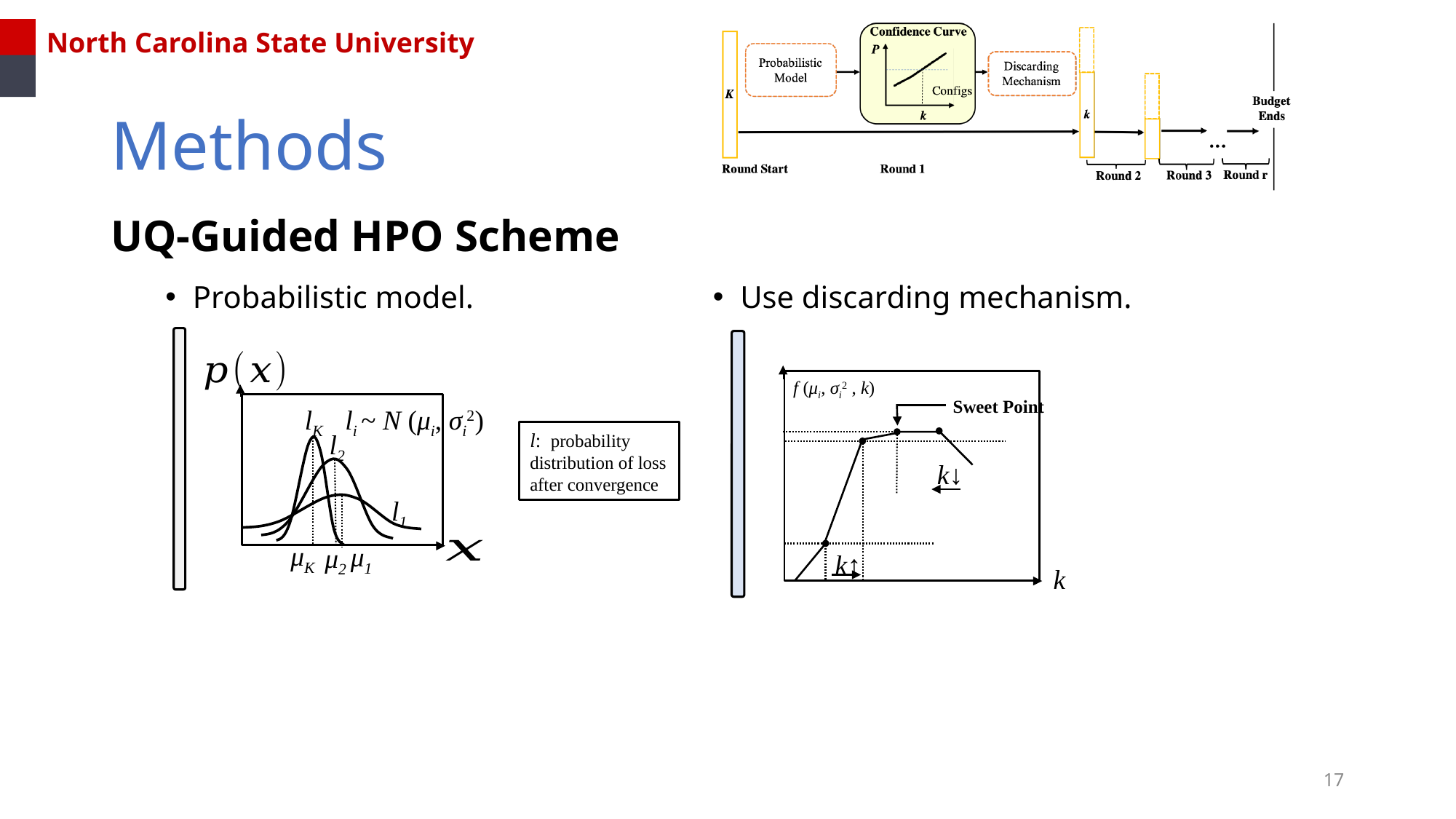
In the right plot of f(μ_i, σ_i², k) versus k, what is the label of the horizontal axis? k In the right plot of f(μ_i, σ_i², k) versus k, does the curve rise or fall after the last marked point to the right of the Sweet Point? fall In the right plot of f(μ_i, σ_i², k) versus k, does the curve rise or fall as k increases from the origin to the Sweet Point? rise What kind of chart is the right plot of f(μ_i, σ_i², k) versus k? line chart In the left plot of p(x) versus x, which curve has the lowest peak? l_1 In the left plot of p(x) versus x, what are the labels of the three curves? l_K, l_2, l_1 In the left plot of p(x) versus x, which curve peaks higher, l_2 or l_1? l_2 In the right plot of f(μ_i, σ_i², k) versus k, how many marked data points are on the curve? 4 In the left plot of p(x) versus x, which curve has the highest peak? l_K In the left plot of p(x) versus x, how many distribution curves are drawn? 3